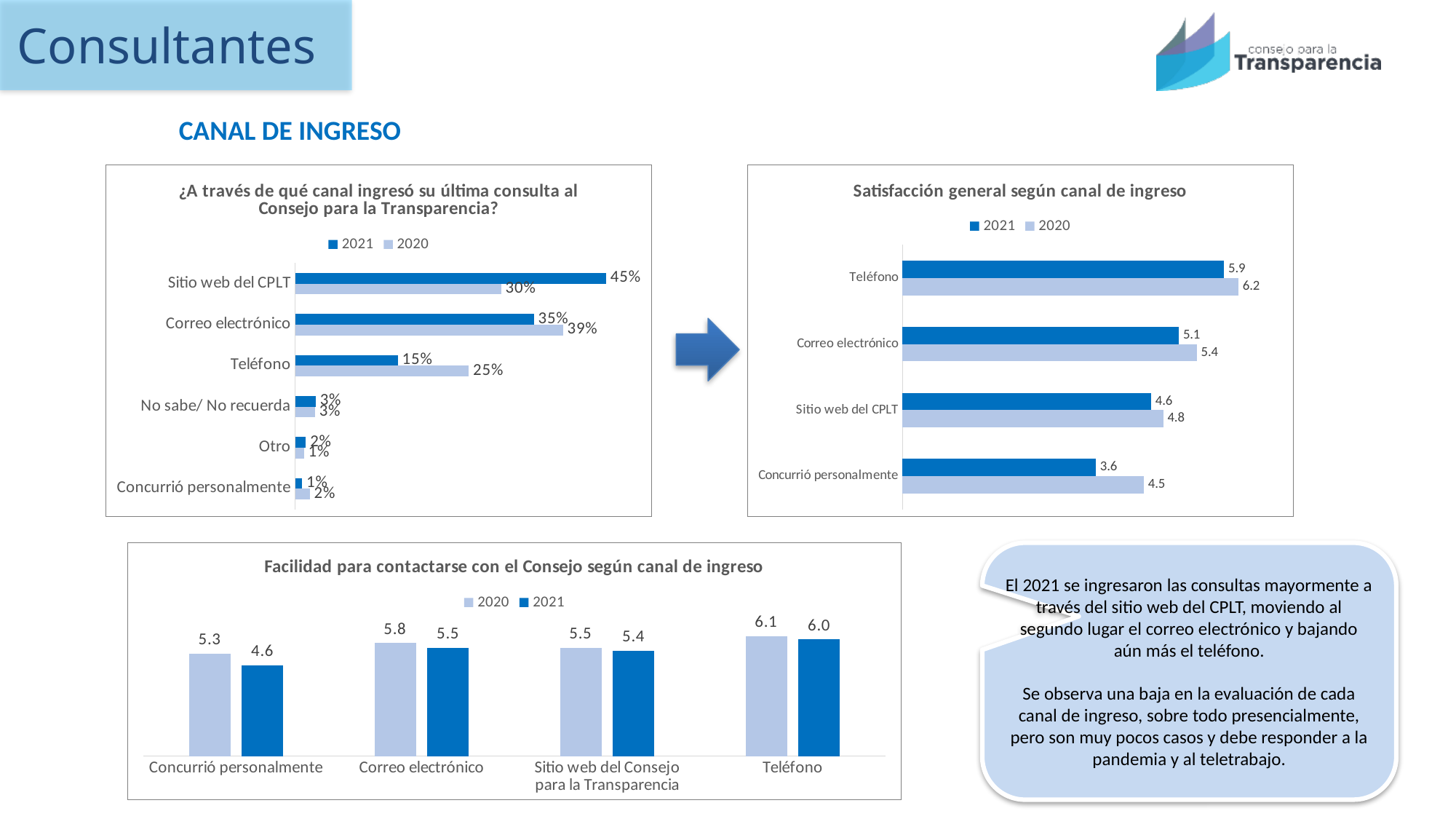
In the chart 'Satisfacción general según canal de ingreso', which channel has the highest 2020 value? Teléfono In the chart 'Facilidad para contactarse con el Consejo según canal de ingreso', which is larger: the 2020 value for Concurrió personalmente or the 2021 value for Concurrió personalmente? 2020 In the chart '¿A través de qué canal ingresó su última consulta al Consejo para la Transparencia?', what is the 2020 value for Teléfono? 25% How many categories are shown in the chart '¿A través de qué canal ingresó su última consulta al Consejo para la Transparencia?'? 6 In the chart '¿A través de qué canal ingresó su última consulta al Consejo para la Transparencia?', what is the difference between the 2021 and 2020 values for Sitio web del CPLT? 15% What kind of chart is 'Facilidad para contactarse con el Consejo según canal de ingreso'? Bar chart In the chart 'Facilidad para contactarse con el Consejo según canal de ingreso', what is the 2020 value for Correo electrónico? 5.8 In the chart 'Satisfacción general según canal de ingreso', what is the 2021 value for Concurrió personalmente? 3.6 In the chart 'Satisfacción general según canal de ingreso', what is the difference between the 2020 and 2021 values for Concurrió personalmente? 0.9 In the chart '¿A través de qué canal ingresó su última consulta al Consejo para la Transparencia?', what is the 2021 value for Sitio web del CPLT? 45% In the chart '¿A través de qué canal ingresó su última consulta al Consejo para la Transparencia?', which channel has the highest 2020 value? Correo electrónico How many series does the legend list in the chart 'Satisfacción general según canal de ingreso'? 2